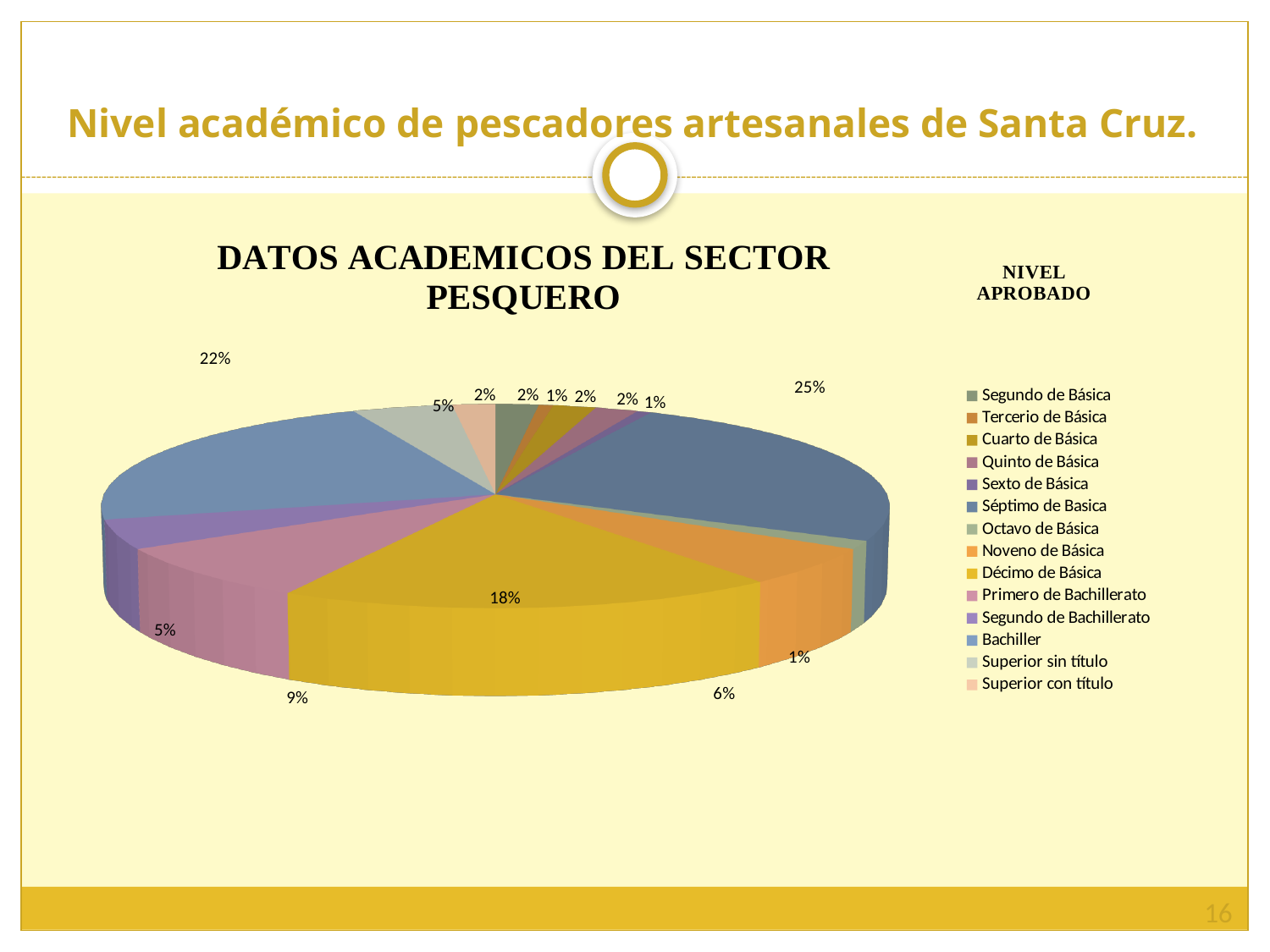
What share of the pie does Noveno de Básica represent? 6% What kind of chart is shown on the slide? pie chart What is the title of the chart? DATOS ACADEMICOS DEL SECTOR PESQUERO What is the difference in percentage points between Séptimo de Basica and Bachiller? 3 percentage points What is the heading shown above the legend of the chart? NIVEL APROBADO What share of the pie does Bachiller represent? 22% Which category has the largest share of the pie? Séptimo de Basica What share of the pie does Décimo de Básica represent? 18% Which is larger, the share for Décimo de Básica or the share for Primero de Bachillerato? Décimo de Básica How many categories does the legend of the pie chart list? 14